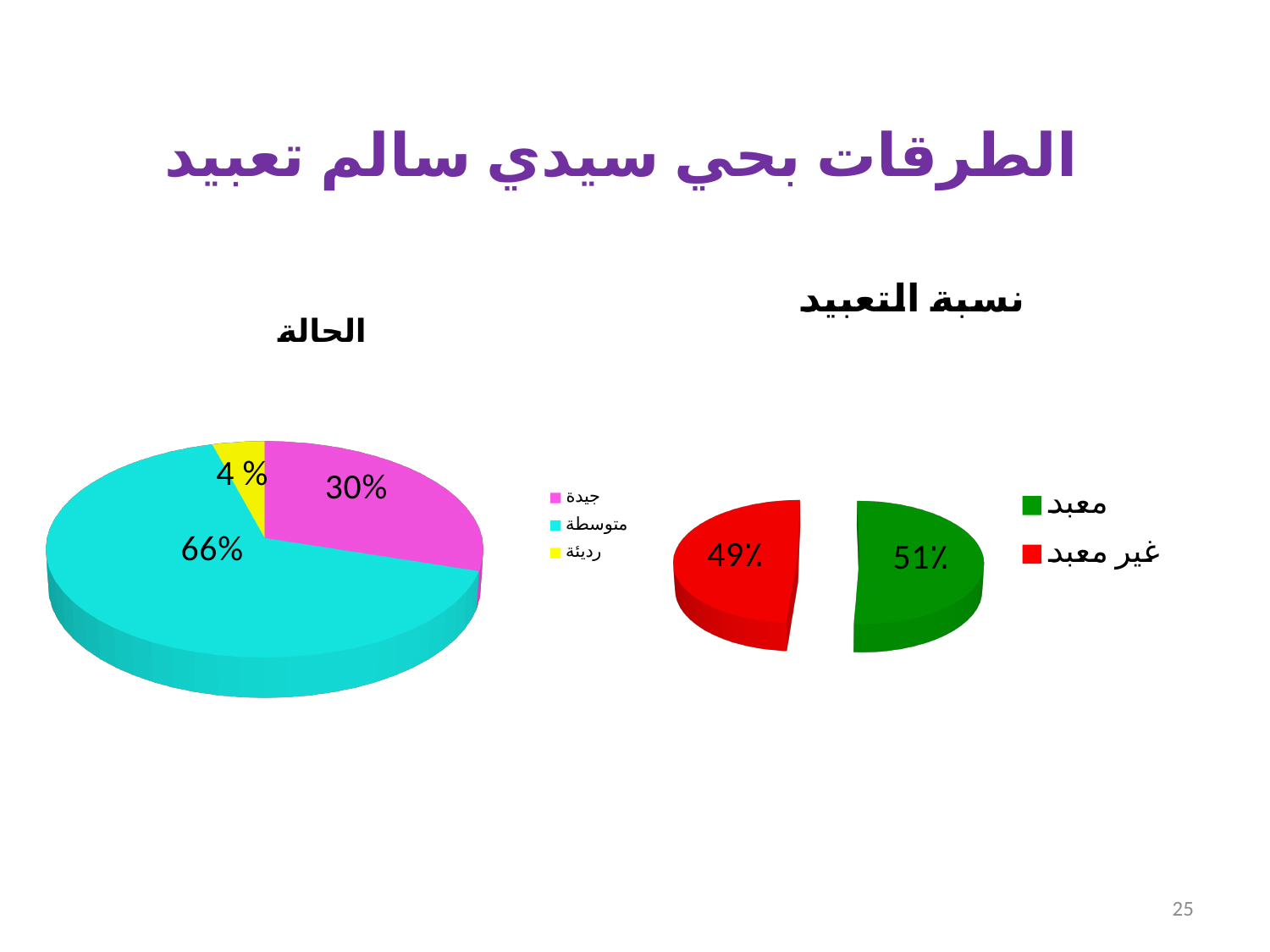
What kind of chart is the chart titled نسبة التعبيد? Pie chart In the chart titled الحالة, which category has the largest slice? متوسطة In the chart titled نسبة التعبيد, what is the value for معبد? 51% In the chart titled الحالة, what is the value for متوسطة? 66% In the chart titled الحالة, how many slices does the pie have? 3 In the chart titled الحالة, what is the value for رديئة? 4% In the chart titled الحالة, what is the value for جيدة? 30% In the chart titled الحالة, which category has the smallest slice? رديئة In the chart titled الحالة, what is the difference between the values for متوسطة and جيدة? 36% In the chart titled نسبة التعبيد, what is the value for غير معبد? 49% In the chart titled نسبة التعبيد, what colour is the slice for غير معبد? Red In the chart titled نسبة التعبيد, which is larger, معبد or غير معبد? معبد